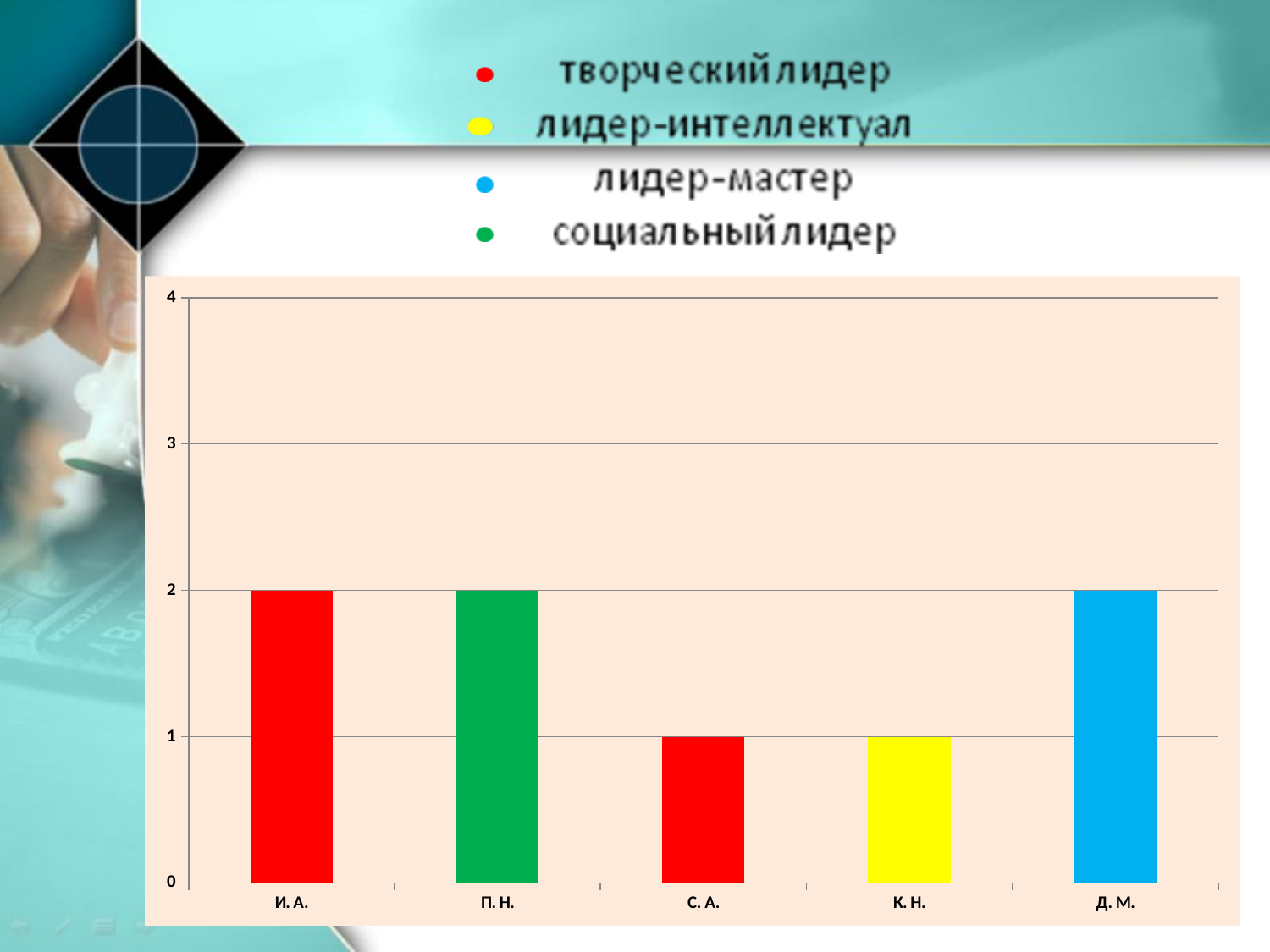
What is the value for К. Н.? 1 What is the value for Д. М.? 2 How many categories are shown on the x axis of the chart? 5 What is the value for И. А.? 2 What is the difference between the value for Д. М. and the value for К. Н.? 1 What is the value for С. А.? 1 Which legend entry is shown in yellow? лидер-интеллектуал What is the value for П. Н.? 2 Which is larger, the value for И. А. or the value for С. А.? И. А. How many entries does the legend list? 4 Is the value for П. Н. greater or less than 1? greater What type of chart is shown on the slide? bar chart